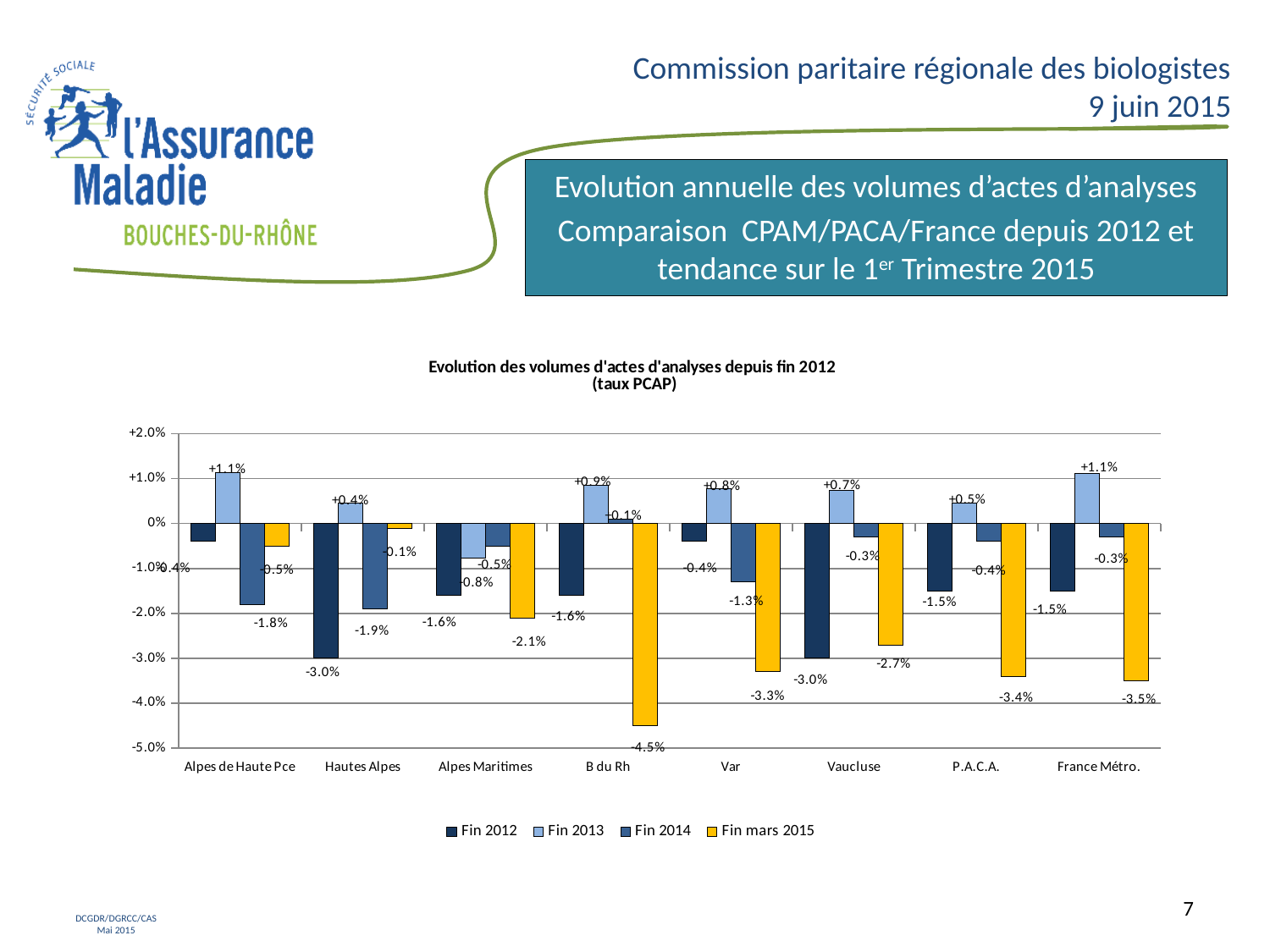
How many series does the legend list? 4 What is the Fin 2014 value for Alpes de Haute Pce? -1.8% Which category has the lowest Fin mars 2015 value? B du Rh What is the title of the chart? Evolution des volumes d'actes d'analyses depuis fin 2012 (taux PCAP) How many categories are shown on the x axis? 8 What kind of chart is shown? Bar chart Which category has the lowest Fin 2014 value? Hautes Alpes What is the difference between the Fin 2012 and Fin 2014 values for Hautes Alpes? 1.1 percentage points Which is larger, the Fin mars 2015 value for Hautes Alpes or for Alpes Maritimes? Hautes Alpes What is the Fin 2013 value for Vaucluse? +0.7% What is the Fin mars 2015 value for B du Rh? -4.5% What is the Fin 2012 value for Hautes Alpes? -3.0%